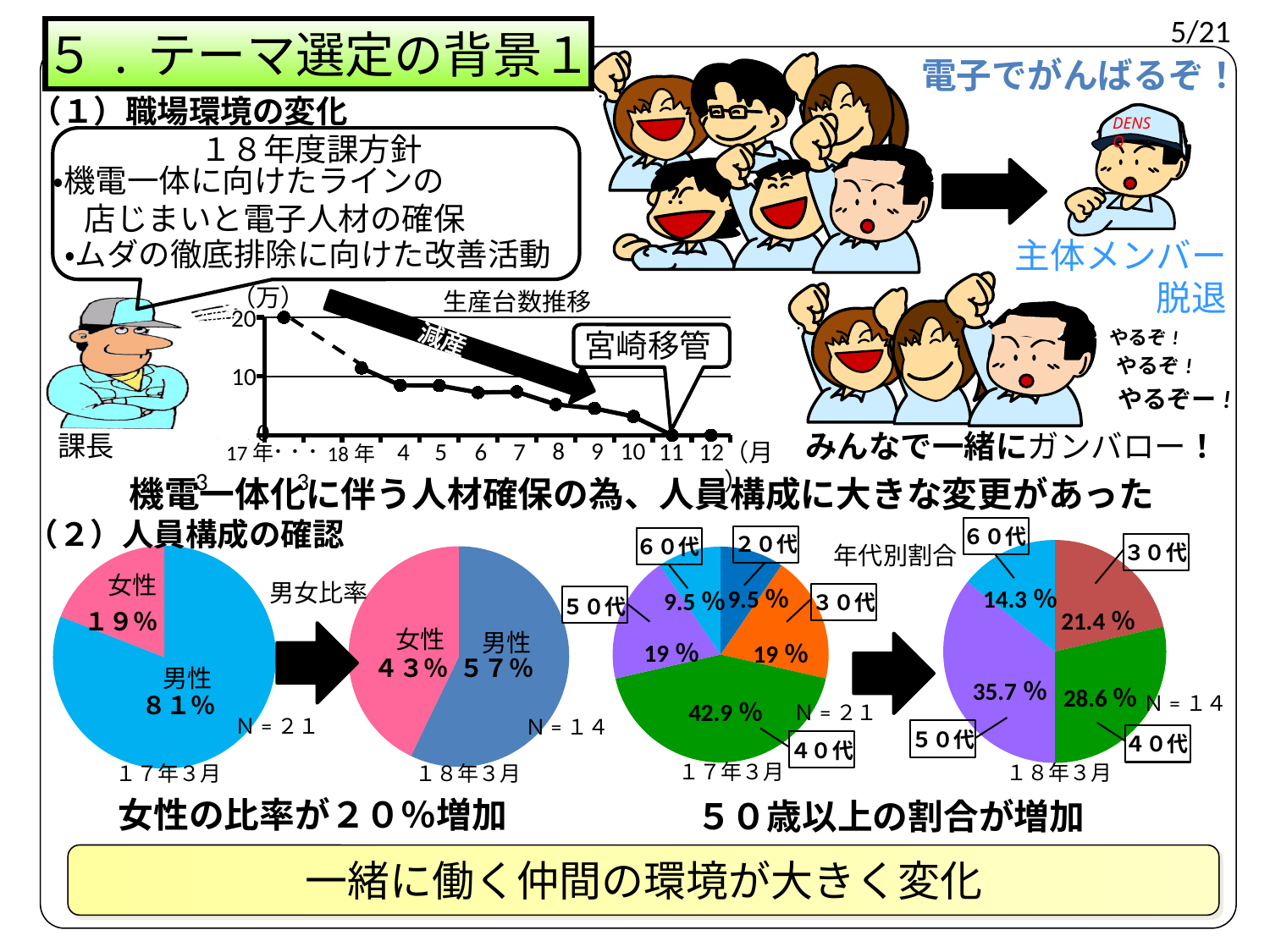
In the 年代別割合 pie chart for 18年3月, which age group has the largest share? 50代 In the 男女比率 pie chart for 18年3月, what is the value for 男性? 57% In the 年代別割合 pie chart for 17年3月, which age group has the largest share? 40代 In the 男女比率 pie chart for 17年3月, what is the value for 女性? 19% How many age-group slices does the 年代別割合 pie chart for 17年3月 have? 5 In the 年代別割合 pie chart for 18年3月, which age group has the smallest share? 60代 What kind of chart is the 生産台数推移 chart? line chart In the 生産台数推移 line chart, do the values rise or fall from 17年 to 11月? fall In the 年代別割合 pie chart for 18年3月, what is the value for 40代? 28.6% In the 年代別割合 pie chart for 17年3月, what is the value for 50代? 19% In the 年代別割合 pie chart for 18年3月, is the share for 50代 larger or smaller than the share for 30代? larger In the 男女比率 pie chart for 17年3月, what is the difference between the 男性 and 女性 shares? 62%